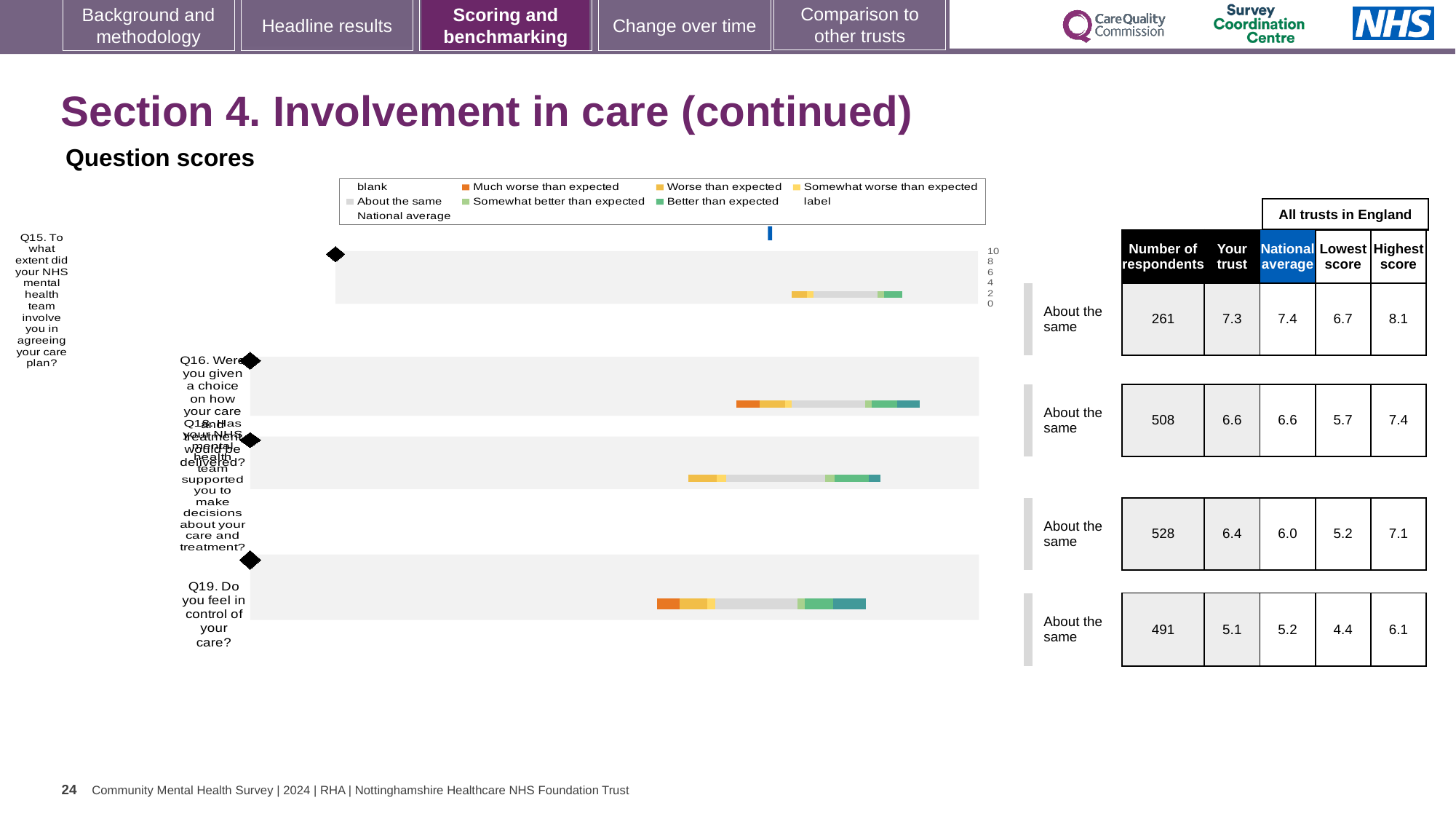
In the table beside the chart, what is the national average for Q16 (Were you given a choice on how your care and treatment would be delivered?)? 6.6 What benchmark category is shown next to the chart for each of the four questions? About the same In the table beside the chart, what is the lowest score across all trusts in England for Q19? 4.4 How many questions (categories) are plotted in the question scores chart? 4 For Q15, which is larger in the table: the 'Your trust' score or the national average? National average In the table beside the chart, how many respondents answered Q18? 528 Which question has the highest 'Your trust' score in the table beside the chart? Q15 Which question has the lowest 'Your trust' score in the table beside the chart? Q19 What kind of chart is used to show the question scores on this slide? bar chart In the table beside the chart, what is the 'Your trust' score for Q19 (Do you feel in control of your care?)? 5.1 What is the difference between the 'Your trust' score and the national average for Q18 in the table? 0.4 In the table beside the chart, what is the highest score across all trusts in England for Q15? 8.1